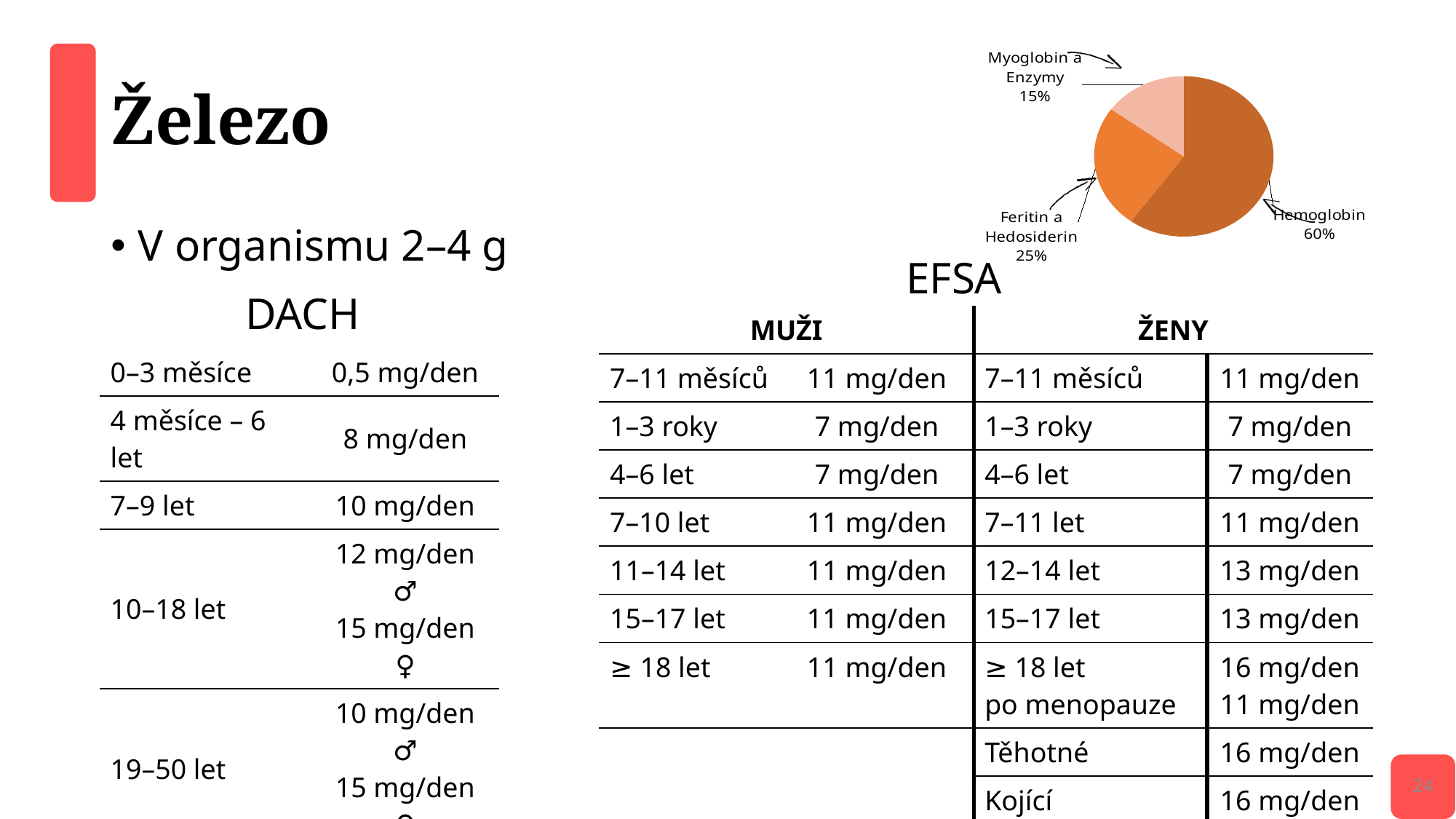
In the pie chart, what is the combined share of Feritin a Hedosiderin and Myoglobin a Enzymy? 40% In the pie chart, what share does Myoglobin a Enzymy have? 15% In the pie chart, what is the difference in percentage points between Hemoglobin and Feritin a Hedosiderin? 35 What kind of chart is shown in the top right of the slide? pie chart In the pie chart, which is larger: Feritin a Hedosiderin or Myoglobin a Enzymy? Feritin a Hedosiderin In the pie chart, what share does Feritin a Hedosiderin have? 25% How many slices does the pie chart have? 3 Which slice of the pie chart is the largest? Hemoglobin In the pie chart, what share does Hemoglobin have? 60% Which slice of the pie chart is the smallest? Myoglobin a Enzymy In the pie chart, what is the difference in percentage points between Feritin a Hedosiderin and Myoglobin a Enzymy? 10 In the pie chart, which slice is shown in the lightest colour? Myoglobin a Enzymy